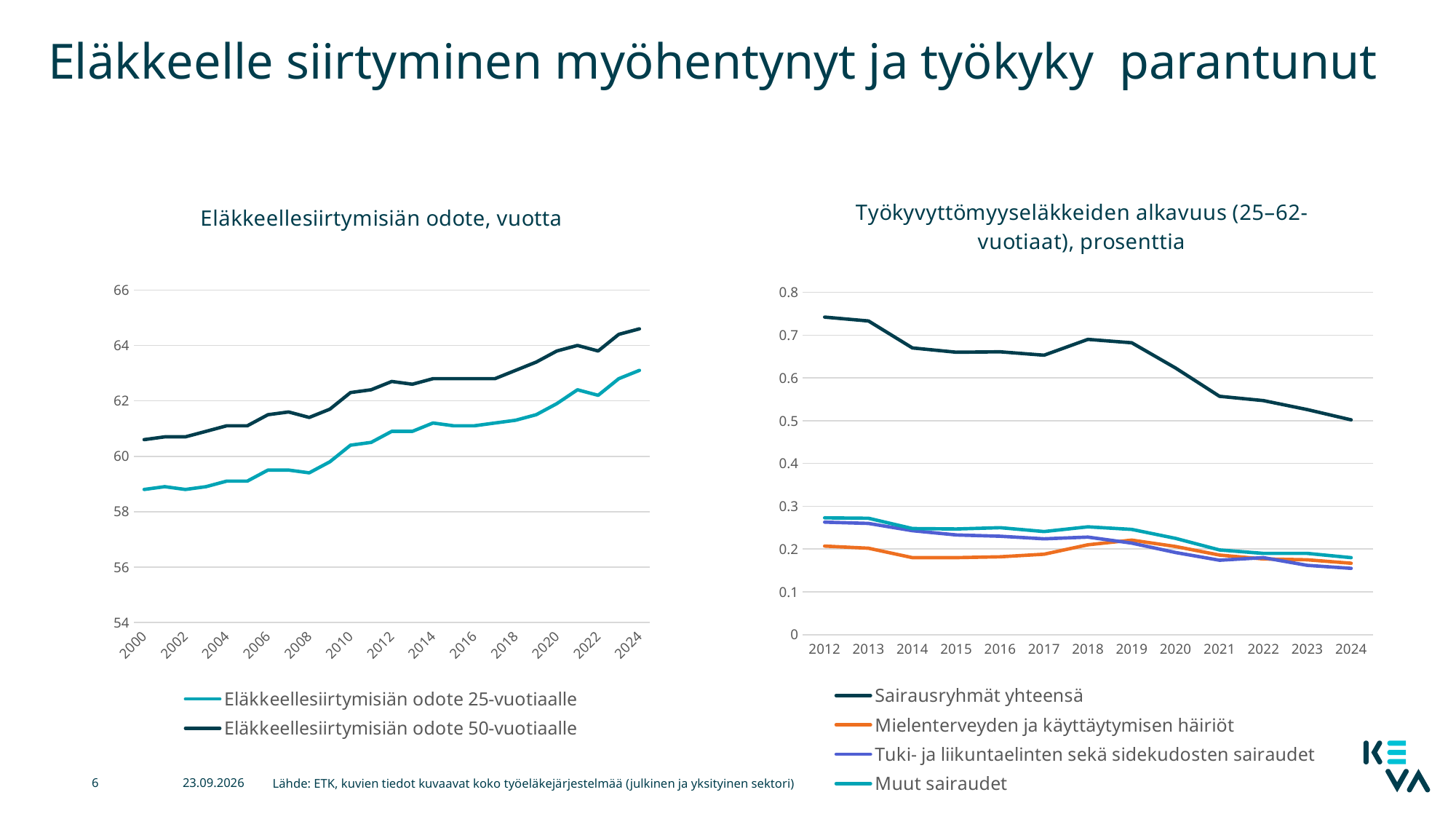
In the right chart (Työkyvyttömyyseläkkeiden alkavuus), is the value for Sairausryhmät yhteensä in 2012 greater or less than 0.7? greater In the right chart (Työkyvyttömyyseläkkeiden alkavuus), which series has the lowest value in 2012? Mielenterveyden ja käyttäytymisen häiriöt In the left chart (Eläkkeellesiirtymisiän odote, vuotta), which series is higher in 2024: 25-vuotiaalle or 50-vuotiaalle? Eläkkeellesiirtymisiän odote 50-vuotiaalle In the left chart (Eläkkeellesiirtymisiän odote, vuotta), is the value for Eläkkeellesiirtymisiän odote 25-vuotiaalle in 2000 greater or less than 60? less In the left chart (Eläkkeellesiirtymisiän odote, vuotta), do the values rise or fall from 2000 to 2024? rise How many years are shown on the x axis of the right chart (Työkyvyttömyyseläkkeiden alkavuus)? 13 In the left chart (Eläkkeellesiirtymisiän odote, vuotta), is the value for Eläkkeellesiirtymisiän odote 50-vuotiaalle in 2024 greater or less than 64? greater What kind of chart is the left chart titled "Eläkkeellesiirtymisiän odote, vuotta"? line chart How many series does the legend of the left chart (Eläkkeellesiirtymisiän odote, vuotta) list? 2 How many series does the legend of the right chart (Työkyvyttömyyseläkkeiden alkavuus) list? 4 What is the title of the right chart? Työkyvyttömyyseläkkeiden alkavuus (25–62-vuotiaat), prosenttia In the right chart (Työkyvyttömyyseläkkeiden alkavuus), does the Sairausryhmät yhteensä series rise or fall from 2012 to 2024? fall